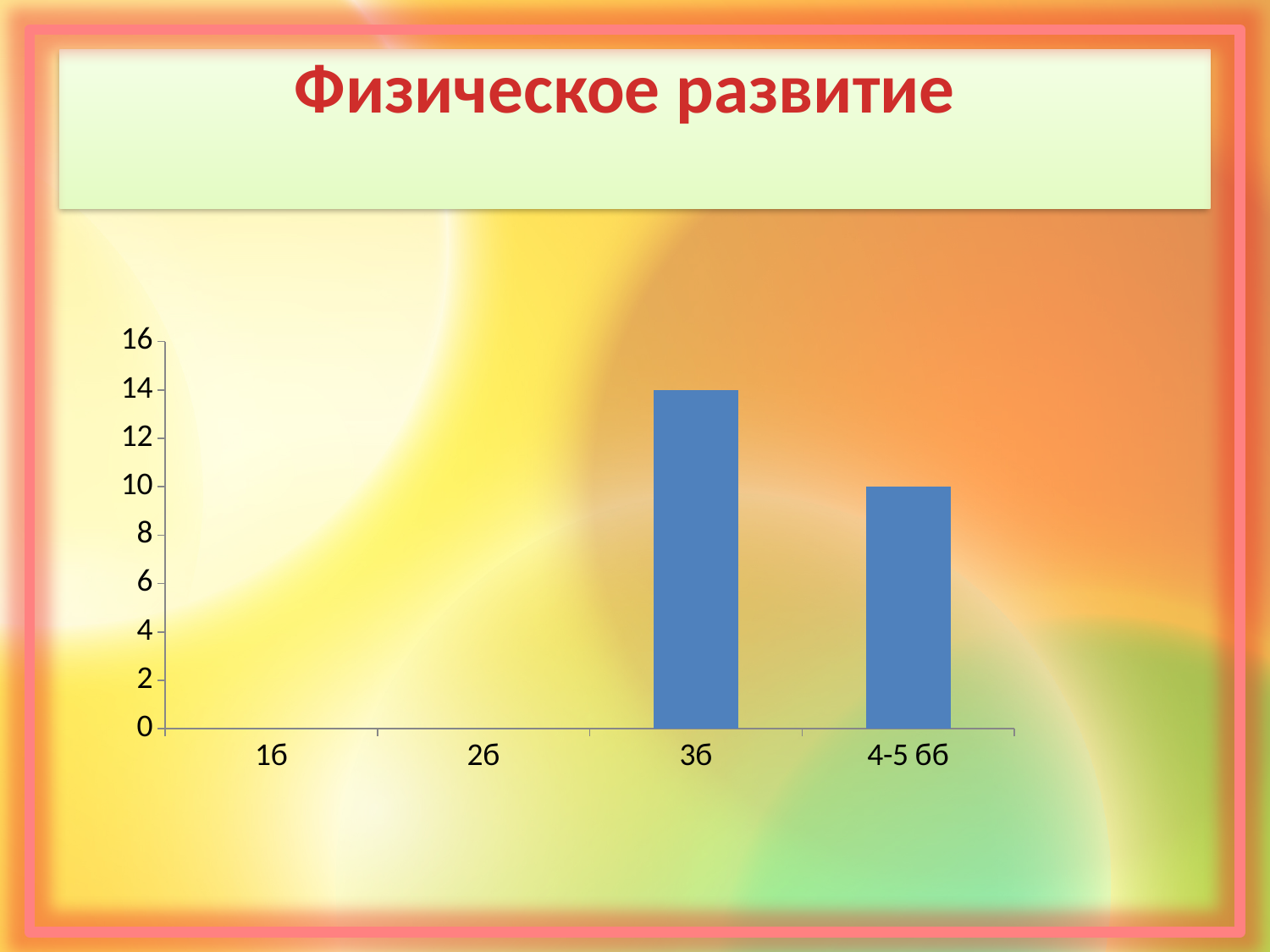
What is the title shown above the chart? Физическое развитие What kind of chart is shown on the slide? bar chart Is the value for 4-5 бб greater or less than 12? less Which category has the highest value? 3б Which is larger, the value for 3б or the value for 4-5 бб? 3б What is the difference between the values for 3б and 4-5 бб? 4 What is the value for 3б? 14 What is the value for 4-5 бб? 10 How many categories have a visible bar? 2 What colour are the bars in the chart? blue Is the value for 3б greater or less than 12? greater How many categories are shown on the x axis? 4